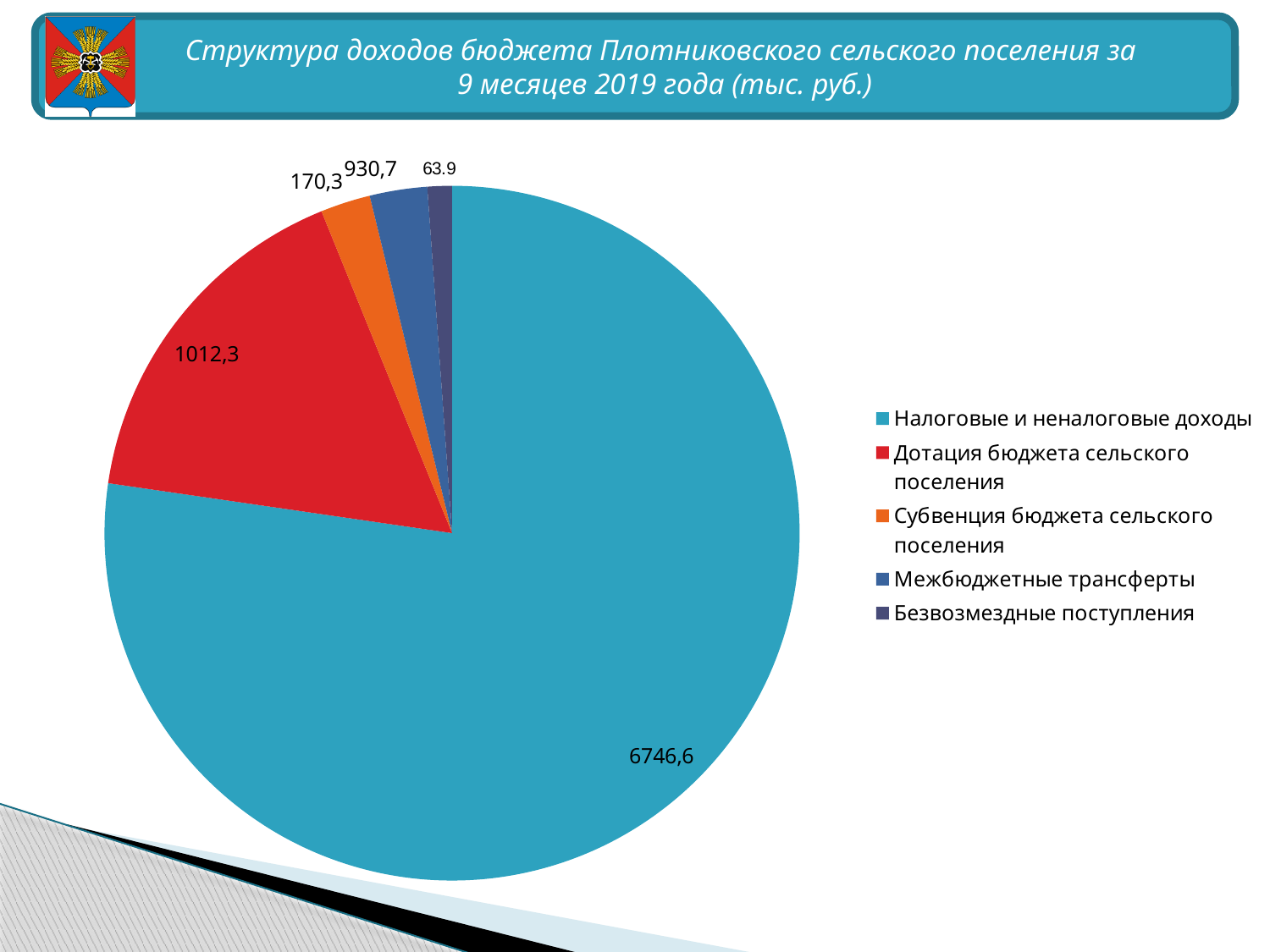
How many entries does the legend list? 5 Which category has the smallest slice of the pie? Безвозмездные поступления What kind of chart is shown on the slide? pie chart Which is larger: Дотация бюджета сельского поселения or Субвенция бюджета сельского поселения? Дотация бюджета сельского поселения What colour is the slice for Дотация бюджета сельского поселения? red Which category has the largest slice of the pie? Налоговые и неналоговые доходы How many slices does the pie chart have? 5 What is the difference between the values for Налоговые и неналоговые доходы and Дотация бюджета сельского поселения? 5734,3 What is the value for Налоговые и неналоговые доходы? 6746,6 What is the value for Безвозмездные поступления? 63.9 What is the value for Дотация бюджета сельского поселения? 1012,3 What is the value for Субвенция бюджета сельского поселения? 170,3